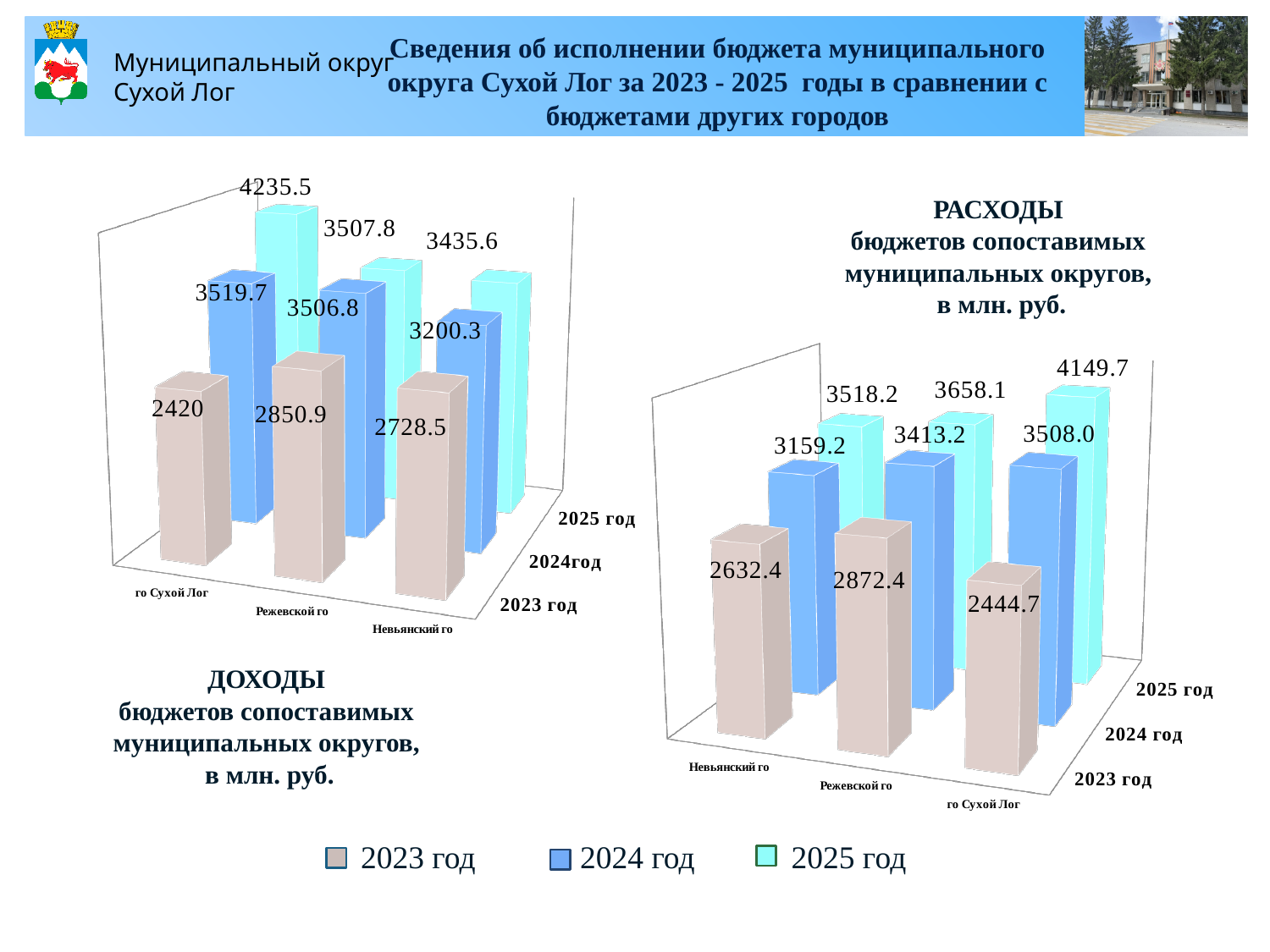
In the ДОХОДЫ chart (left), what is the value for Режевской го in 2023 год? 2850.9 In the РАСХОДЫ chart (right), what is the difference between the 2025 год values for Режевской го and Невьянский го? 139.9 In the ДОХОДЫ chart (left), which is larger: the 2024 год value for го Сухой Лог or for Невьянский го? го Сухой Лог How many series does the legend list? 3 In the РАСХОДЫ chart (right), what is the value for Невьянский го in 2024 год? 3159.2 In the ДОХОДЫ chart (left), which category has the lowest value for 2023 год? го Сухой Лог In the РАСХОДЫ chart (right), what is the value for го Сухой Лог in 2023 год? 2444.7 In the ДОХОДЫ chart (left), what is the difference between the 2025 год and 2023 год values for го Сухой Лог? 1815.5 In the ДОХОДЫ chart (left), what is the value for го Сухой Лог in 2025 год? 4235.5 In the РАСХОДЫ chart (right), which category has the highest value for 2025 год? го Сухой Лог What kind of chart is the ДОХОДЫ chart (left)? Bar chart How many categories (municipal districts) are shown in the РАСХОДЫ chart (right)? 3